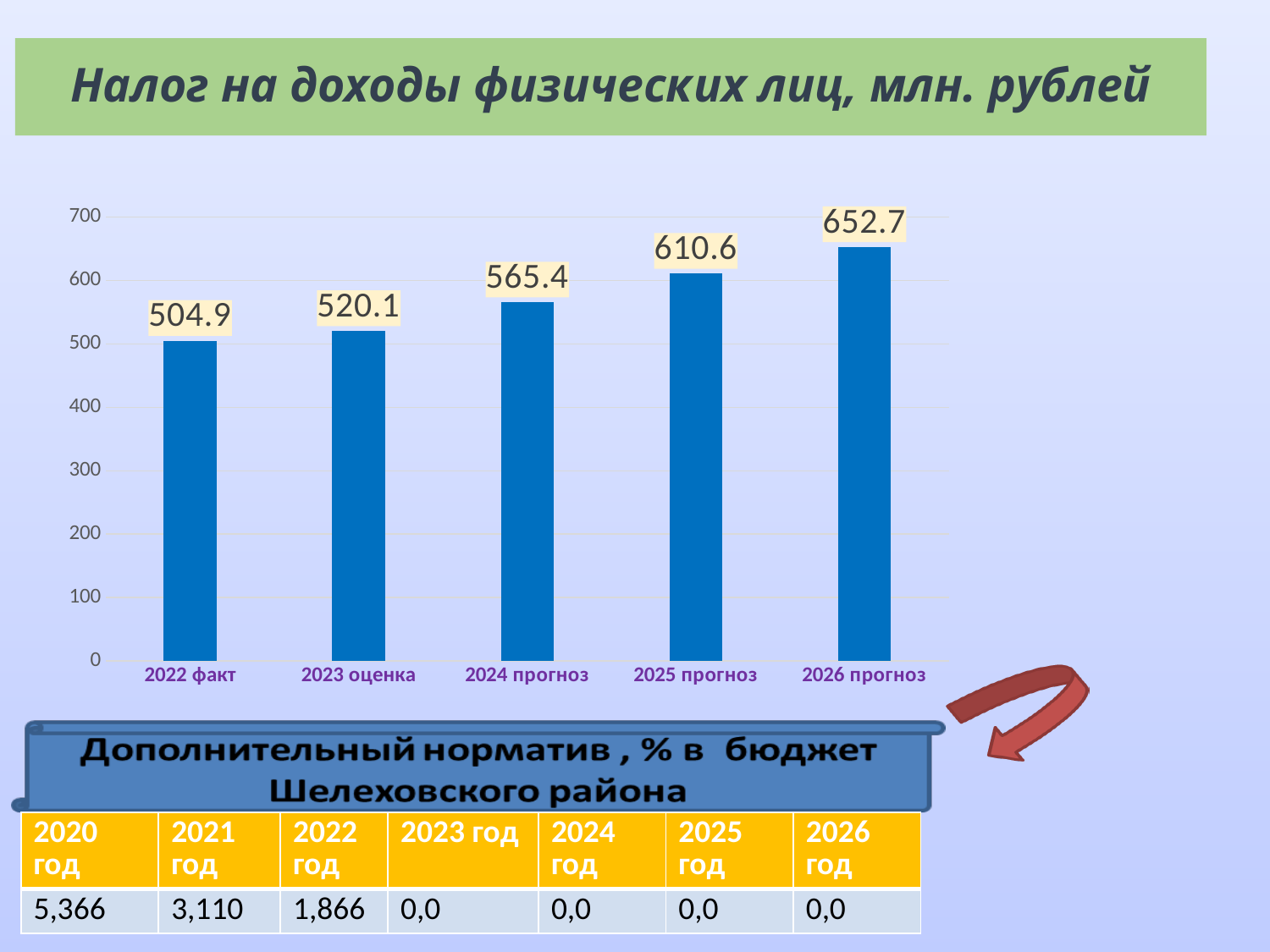
Which is larger, the value for 2023 оценка or the value for 2025 прогноз? 2025 прогноз Which category has the highest value? 2026 прогноз What is the difference between the values for 2026 прогноз and 2022 факт? 147.8 How many categories are shown on the x axis of the chart? 5 What kind of chart is shown on the slide? bar chart Which category has the lowest value? 2022 факт Do the values rise or fall from 2022 факт to 2026 прогноз? rise What is the value for 2022 факт? 504.9 What is the value for 2026 прогноз? 652.7 Is the value for 2025 прогноз greater or less than 600? greater What is the difference between the values for 2025 прогноз and 2024 прогноз? 45.2 What is the value for 2024 прогноз? 565.4